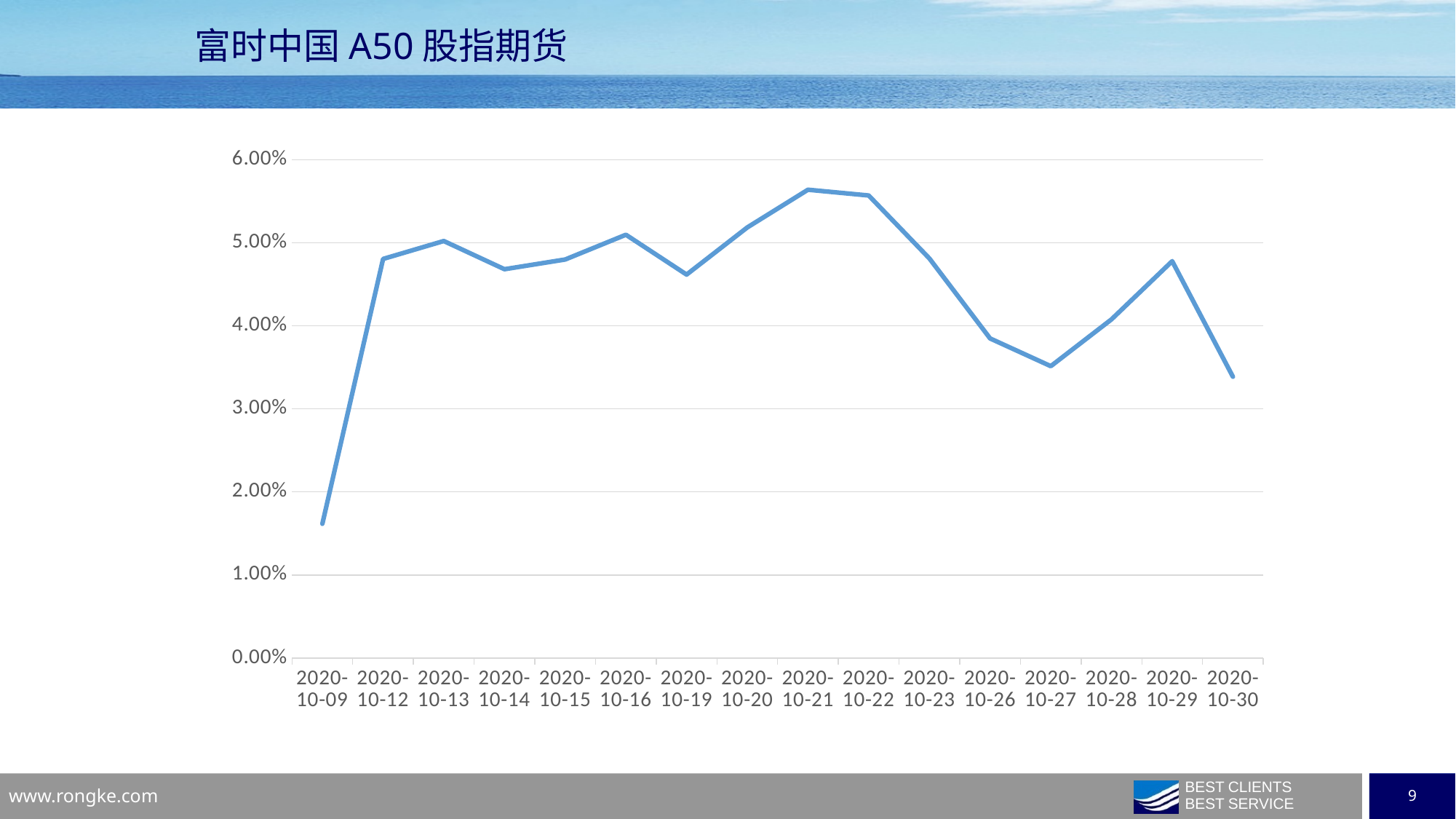
What kind of chart is shown on the slide? line chart Is the value for 2020-10-30 greater or less than 4.00%? less Does the line rise or fall from 2020-10-22 to 2020-10-27? fall Which date has the lowest value? 2020-10-09 Which is larger, the value for 2020-10-29 or the value for 2020-10-30? 2020-10-29 How many dates are plotted along the x axis? 16 Is the value for 2020-10-09 greater or less than 2.00%? less Which is larger, the value for 2020-10-21 or the value for 2020-10-27? 2020-10-21 Is the value for 2020-10-21 greater or less than 5.00%? greater What is the title of the chart? 富时中国 A50 股指期货